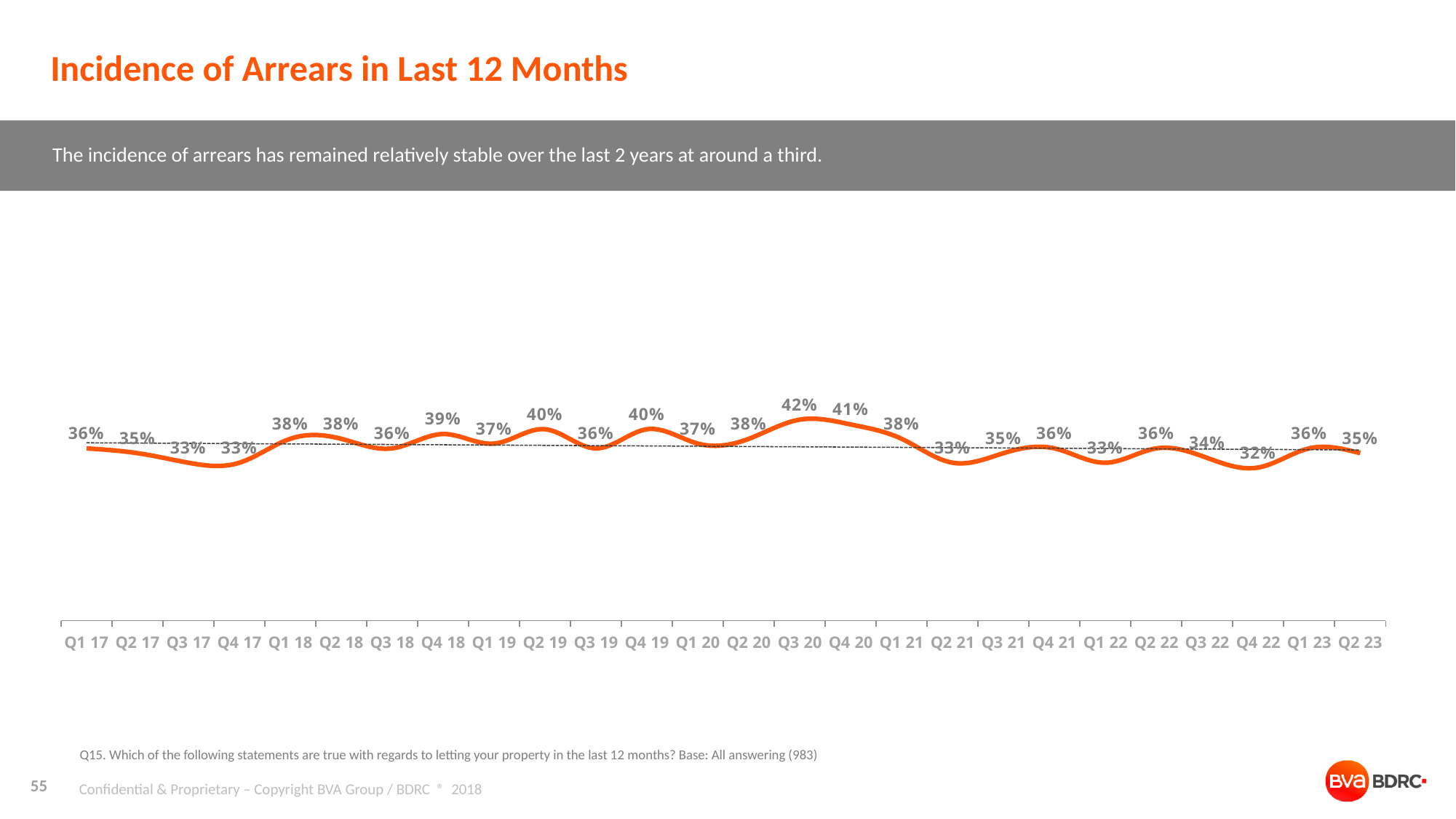
What is the value for Q3 20? 42% What is the value for Q4 22? 32% What is the value for Q2 23? 35% What is the difference between the values for Q1 21 and Q2 21? 5% Which is larger, the value for Q2 19 or the value for Q3 19? Q2 19 Which quarter has the highest incidence of arrears? Q3 20 Which quarter has the lowest incidence of arrears? Q4 22 What kind of chart is shown on the slide? Line chart What is the difference between the values for Q3 20 and Q4 22? 10% What is the value for Q1 17? 36% What is the title of the chart? Incidence of Arrears in Last 12 Months How many quarters are plotted on the chart? 26